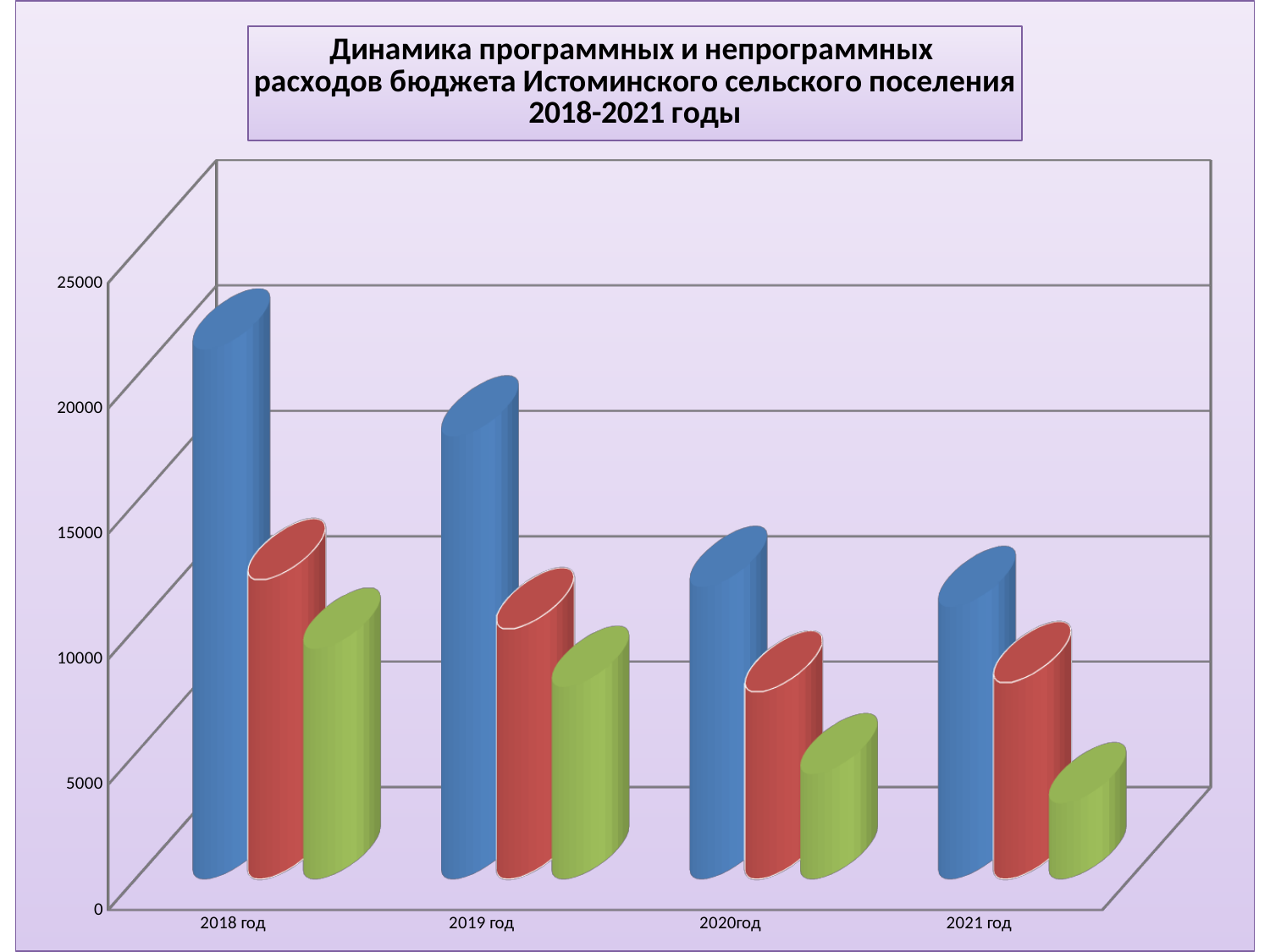
How many bars are plotted for each year category? 3 Is the value of the red bar for 2018 год greater or less than 10000? greater How many year categories are shown on the x axis? 4 Which year has the highest blue bar? 2018 год What kind of chart is shown on the slide? bar chart Is the value of the red bar for 2019 год greater or less than 15000? less Do the blue bars rise or fall from 2018 год to 2021 год? fall Is the value of the blue bar for 2019 год greater or less than 15000? greater Which of the three bars for 2018 год is the shortest? the green bar Which is larger: the blue bar for 2018 год or the blue bar for 2021 год? the blue bar for 2018 год